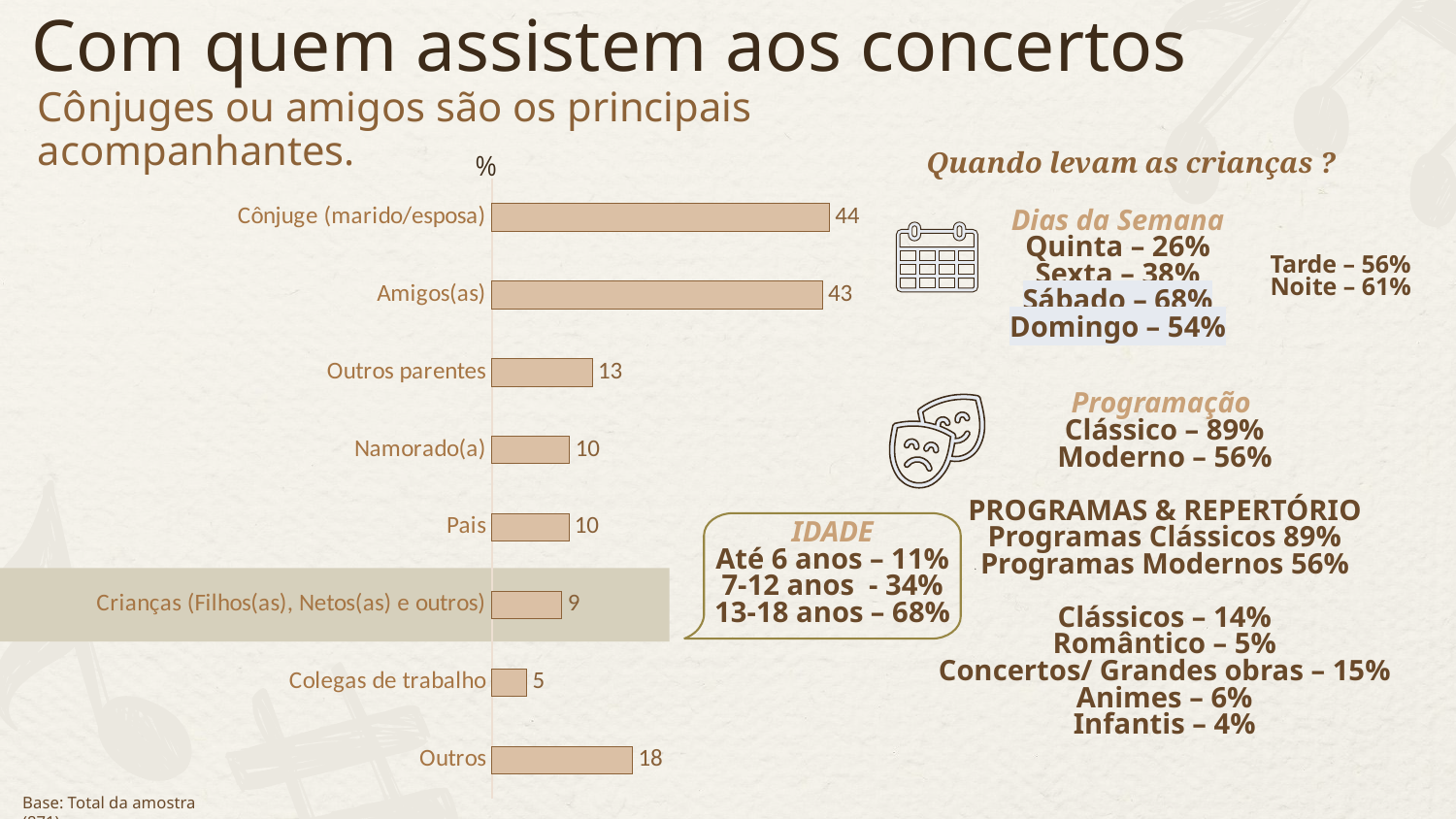
Which category has the highest value in the chart? Cônjuge (marido/esposa) What value is shown for Outros parentes? 13 What value is shown for Cônjuge (marido/esposa)? 44 What unit label is shown at the top of the chart's axis? % What kind of chart is shown on the slide? Bar chart What value is shown for Outros? 18 Which is larger, the value for Outros or the value for Namorado(a)? Outros What is the difference between the values for Cônjuge (marido/esposa) and Outros parentes? 31 Which category has the lowest value in the chart? Colegas de trabalho What value is shown for Colegas de trabalho? 5 How many categories are shown in the bar chart? 8 What value is shown for Amigos(as)? 43